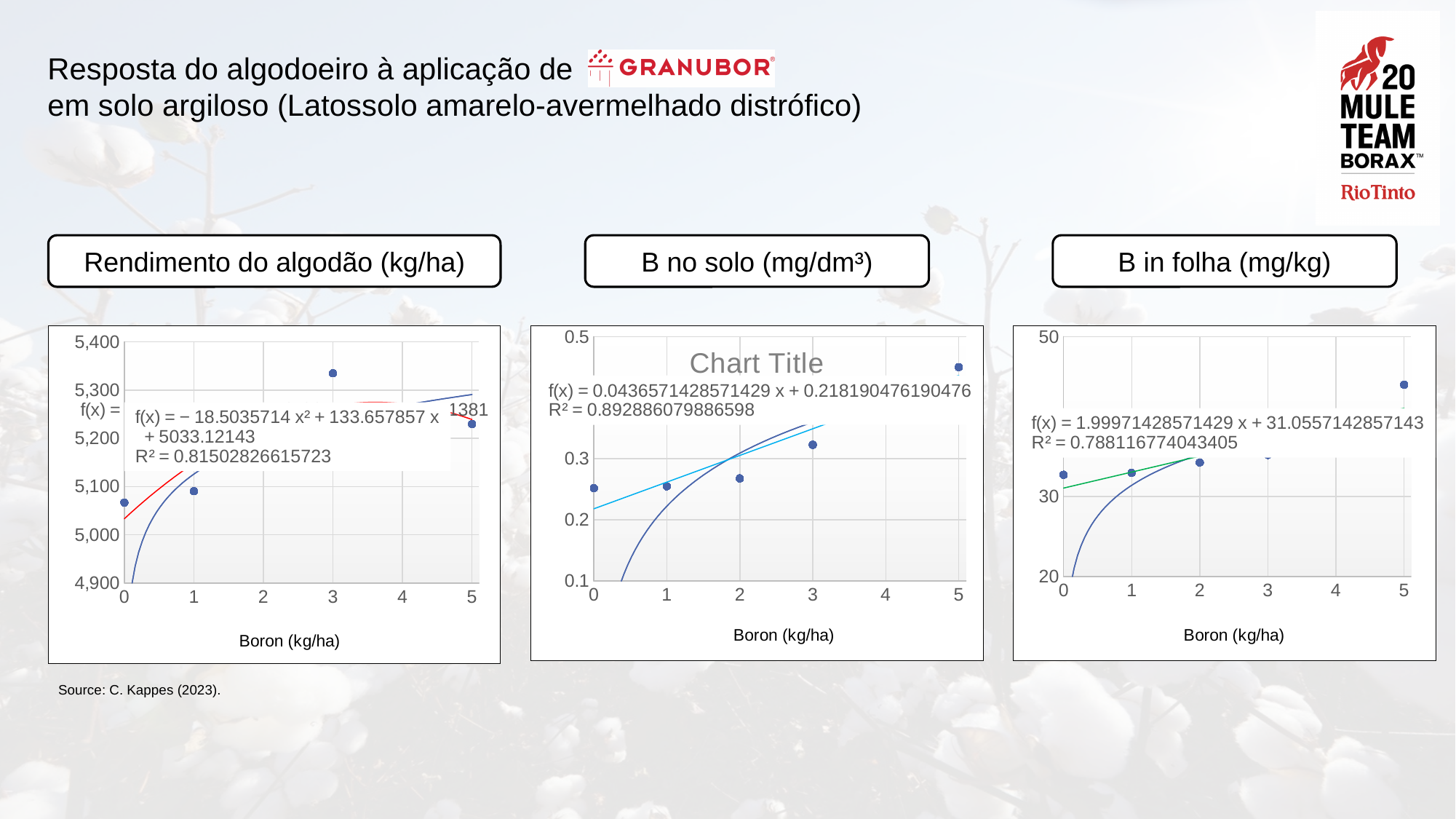
In the "Rendimento do algodão (kg/ha)" chart, what R² value is shown for the fitted equation? 0.81502826615723 In the "Rendimento do algodão (kg/ha)" chart, at which boron rate is the plotted yield highest? 3 In the "B in folha (mg/kg)" chart, is the value at boron 5 greater or less than 40? greater What kind of chart is the "Rendimento do algodão (kg/ha)" chart? scatter chart What is the x-axis label on the "B in folha (mg/kg)" chart? Boron (kg/ha) In the "B in folha (mg/kg)" chart, which boron rate has the lowest plotted value? 0 In the "B no solo (mg/dm³)" chart, do the plotted values rise or fall as the boron rate increases? rise In the "Rendimento do algodão (kg/ha)" chart, is the value at boron 0 greater or less than 5,100? less In the "B no solo (mg/dm³)" chart, is the value at boron 5 greater or less than 0.4? greater In the "B no solo (mg/dm³)" chart, at which boron rate is the plotted value highest? 5